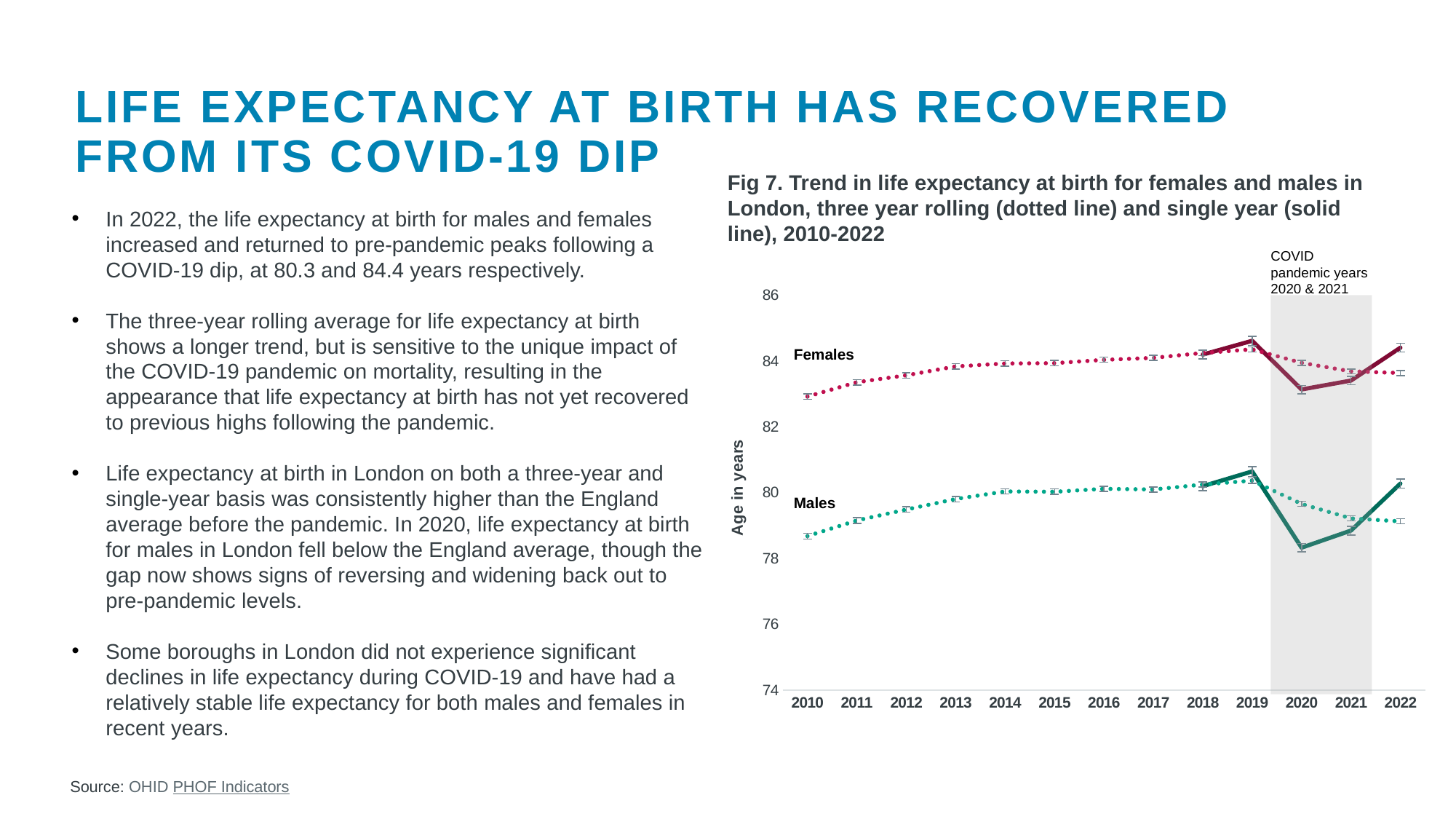
In Fig 7, does the three-year rolling (dotted) line for males rise or fall between 2010 and 2019? rise What is the y-axis label of the chart in Fig 7? Age in years In Fig 7, in which year does the single-year (solid) line for males reach its lowest point? 2020 In Fig 7, which group has the higher life expectancy in 2010, females or males? Females How many groups (series labels) are shown on the chart in Fig 7? 2 (Females and Males) What does the shaded grey area in Fig 7 mark? COVID pandemic years 2020 & 2021 How many years are shown on the x axis of Fig 7? 13 In Fig 7, is the single-year life expectancy for males in 2020 greater or less than 80? less In Fig 7, is the life expectancy for males in 2010 greater or less than 80? less What kind of chart is Fig 7? line chart In Fig 7, is the single-year life expectancy for females in 2019 greater or less than 84? greater